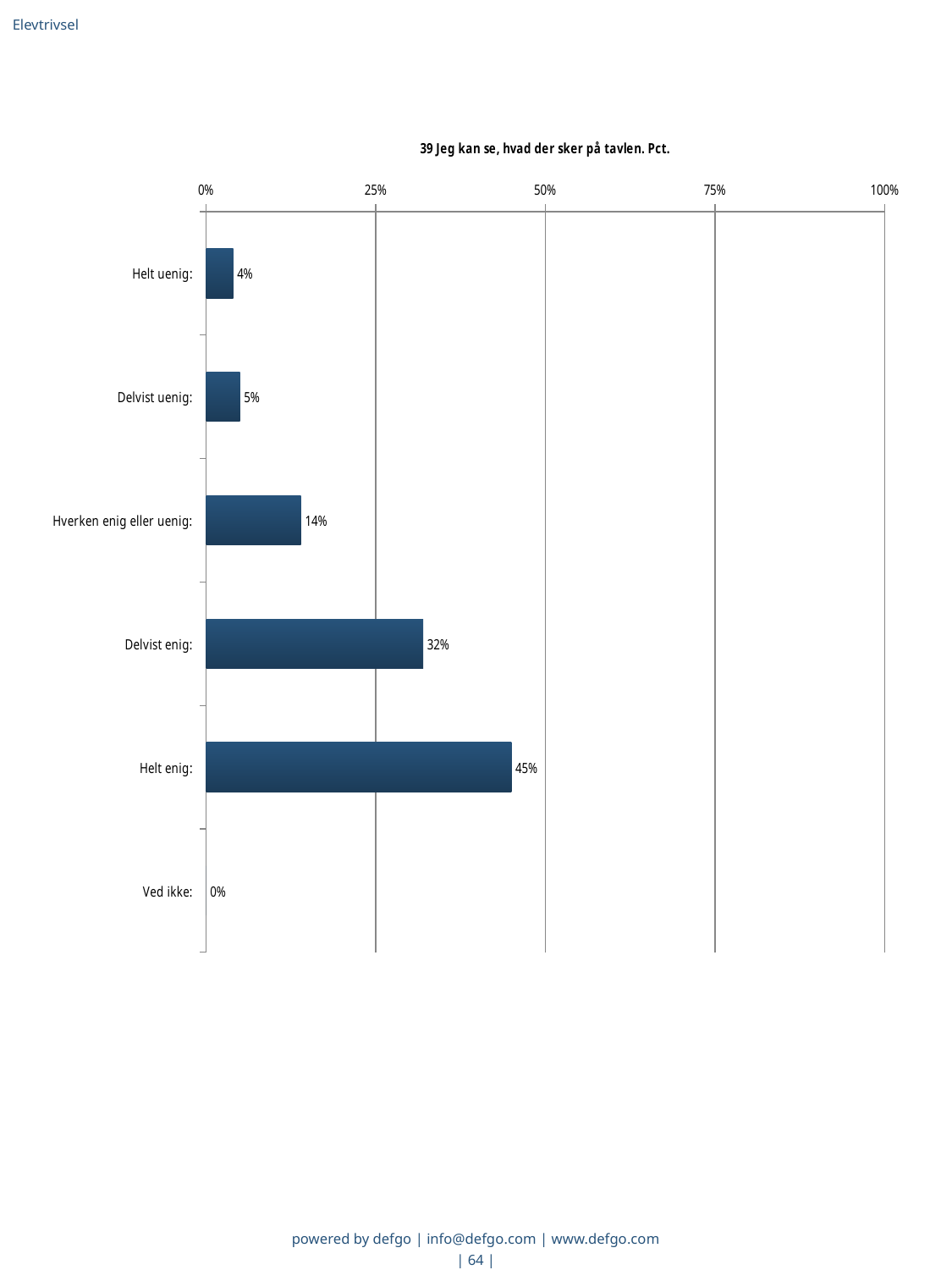
Which category has the lowest value? Ved ikke What is the value for "Delvist enig"? 32% How many categories are shown in the chart? 6 Which is larger, the value for "Delvist uenig" or the value for "Helt uenig"? Delvist uenig What is the value for "Ved ikke"? 0% Is the value for "Delvist enig" greater or less than 25%? greater What is the difference between the values for "Helt enig" and "Delvist enig"? 13% What is the title of the chart? 39 Jeg kan se, hvad der sker på tavlen. Pct. What kind of chart is shown on the slide? bar chart What is the value for "Hverken enig eller uenig"? 14% Which category has the highest value? Helt enig What is the value for "Helt enig"? 45%